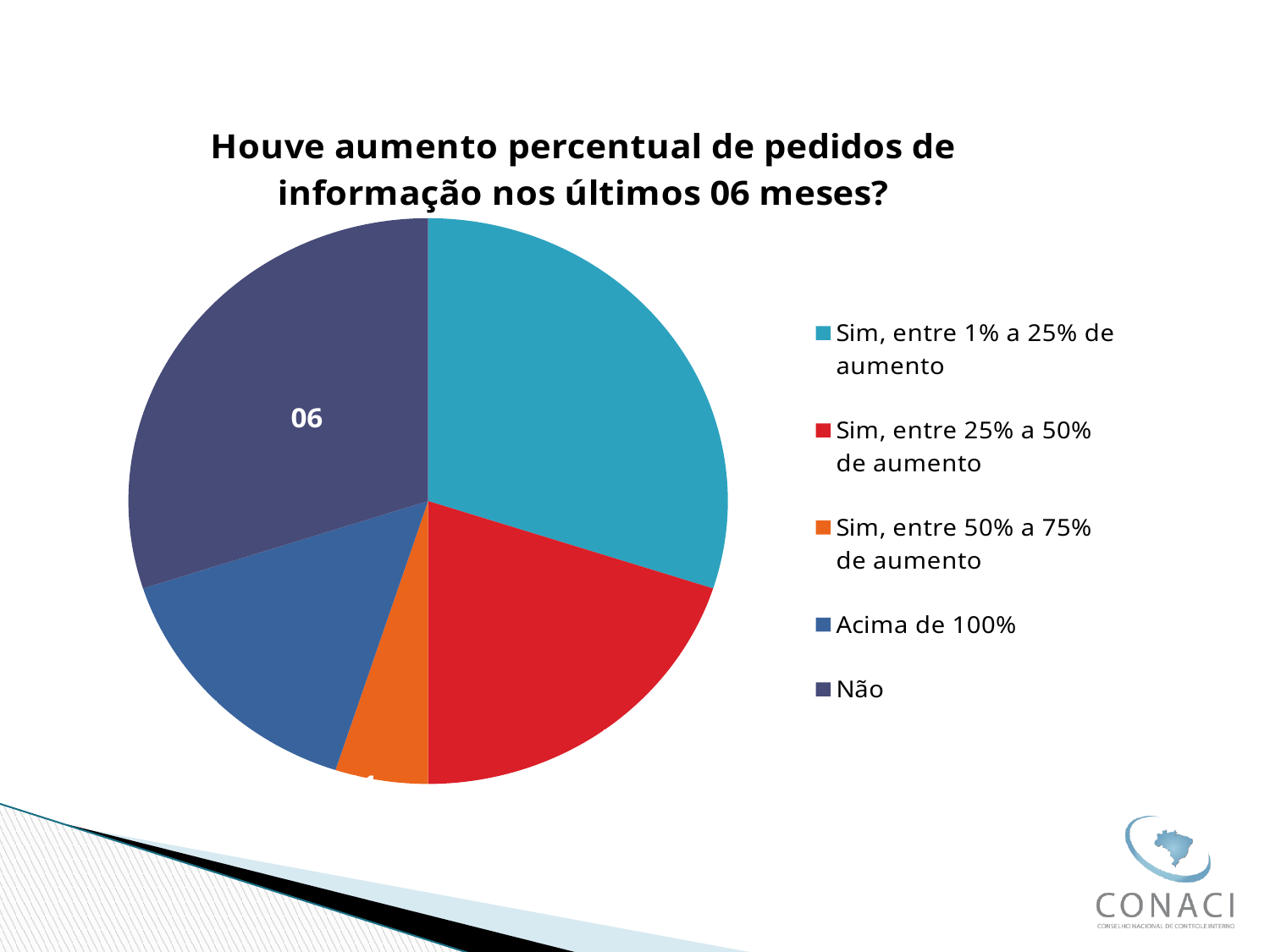
What is the title of the chart? Houve aumento percentual de pedidos de informação nos últimos 06 meses? What value is labelled on the "Não" slice of the pie chart? 06 Which slice is larger: "Sim, entre 1% a 25% de aumento" or "Sim, entre 25% a 50% de aumento"? Sim, entre 1% a 25% de aumento Which category has the smallest slice of the pie chart? Sim, entre 50% a 75% de aumento What kind of chart is shown on the slide? pie chart Which slice is larger: "Acima de 100%" or "Sim, entre 50% a 75% de aumento"? Acima de 100% Which slice is larger: "Não" or "Acima de 100%"? Não Which colour represents "Não" in the pie chart legend? dark purple/blue How many categories does the legend of the pie chart list? 5